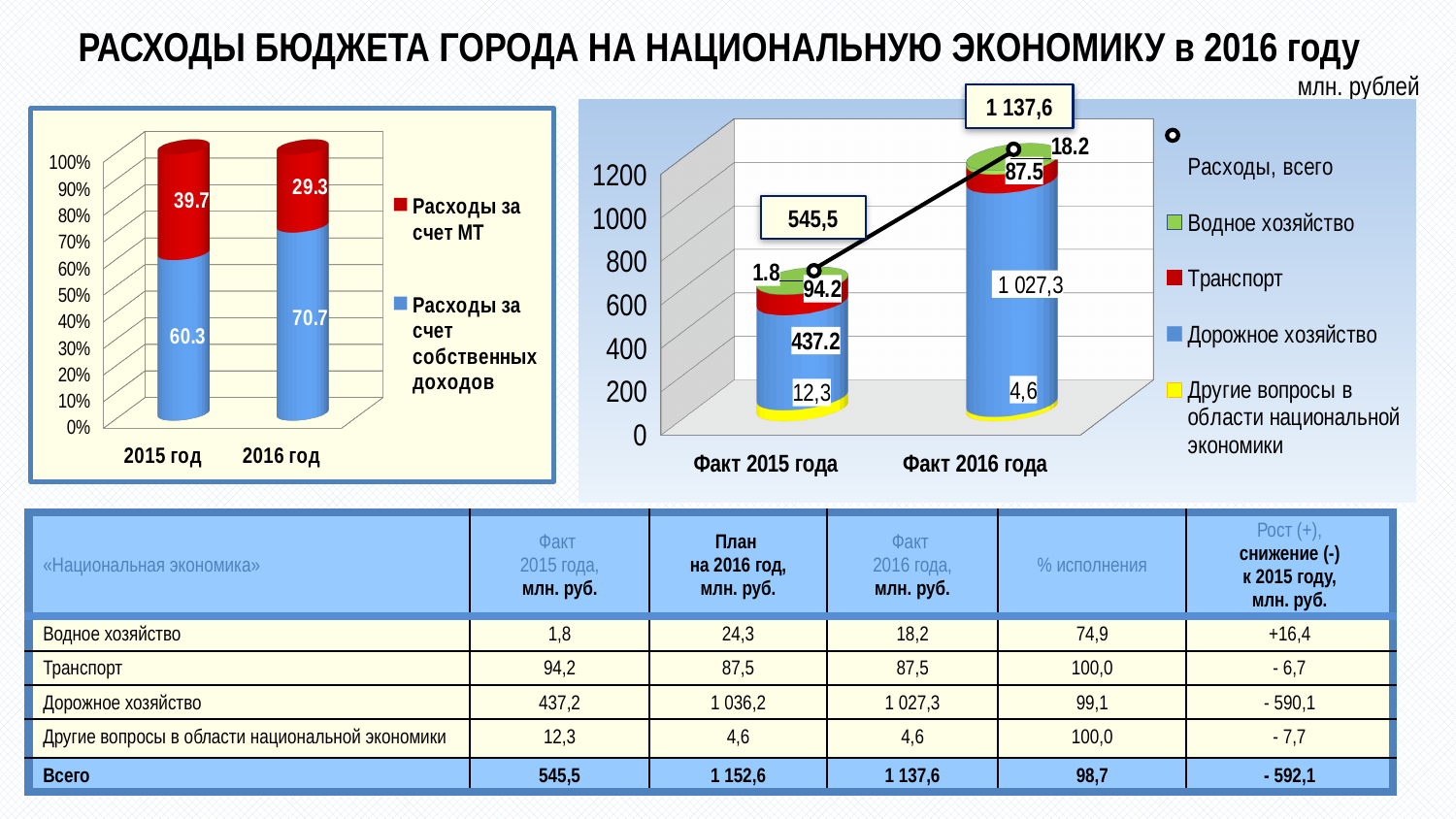
In the right chart, what is the value for 'Другие вопросы в области национальной экономики' for Факт 2015 года? 12,3 In the left chart, what is the value for 'Расходы за счет собственных доходов' in 2015 год? 60.3 In the right chart, what is the total 'Расходы, всего' for Факт 2016 года? 1 137,6 In the left chart, what is the difference between the 'Расходы за счет собственных доходов' values for 2016 год and 2015 год? 10.4 In the right chart, what is the value for 'Дорожное хозяйство' for Факт 2016 года? 1 027,3 In the left chart, which year has the larger share of 'Расходы за счет МТ', 2015 год or 2016 год? 2015 год In the right chart, does 'Расходы, всего' rise or fall from Факт 2015 года to Факт 2016 года? rise In the left chart, what is the value for 'Расходы за счет МТ' in 2016 год? 29.3 In the left chart, how many series does the legend list? 2 In the right chart, how many categories are shown on the x axis? 2 What kind of chart is the left chart? stacked bar chart In the right chart, what is the value for 'Транспорт' for Факт 2015 года? 94.2